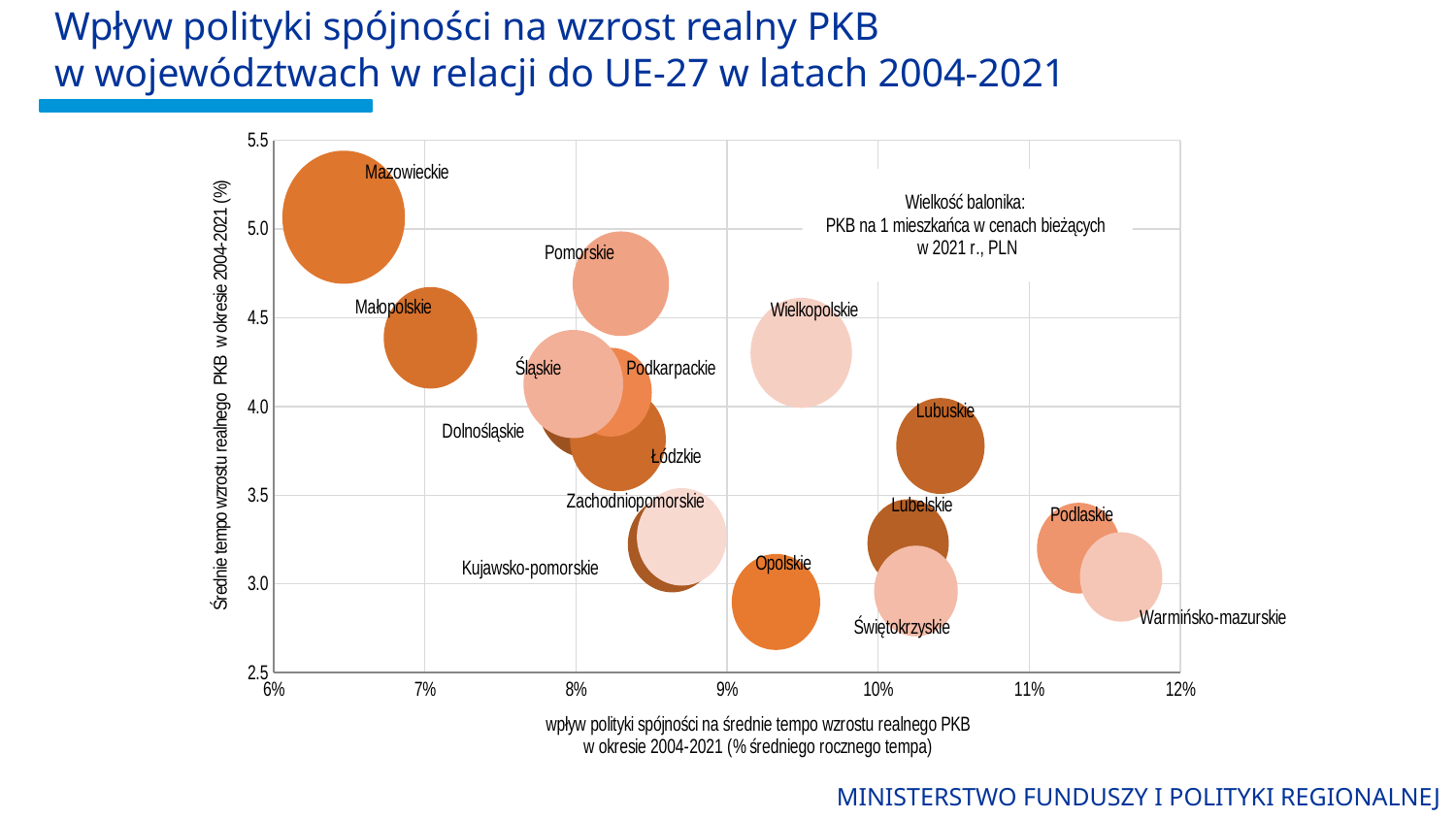
Which has a higher average real GDP growth rate, Pomorskie or Wielkopolskie? Pomorskie What kind of chart is shown on the slide? bubble chart Is the horizontal-axis value for Lubuskie greater or less than 10%? greater Which voivodeship has the highest average real GDP growth rate (vertical axis)? Mazowieckie How many voivodeships (bubbles) are plotted on the chart? 16 Is the vertical-axis value for Pomorskie greater or less than 4.5? greater According to the note on the chart, what does the size of a bubble represent? PKB na 1 mieszkańca w cenach bieżących w 2021 r., PLN Which voivodeship has the lowest value on the horizontal axis (impact of cohesion policy)? Mazowieckie As the impact of cohesion policy on the horizontal axis increases, do the average growth rates of the voivodeships generally rise or fall? fall Which voivodeship has the largest bubble? Mazowieckie Is the vertical-axis value for Podlaskie greater or less than 3.5? less Which voivodeship has the highest value on the horizontal axis (impact of cohesion policy)? Warmińsko-mazurskie